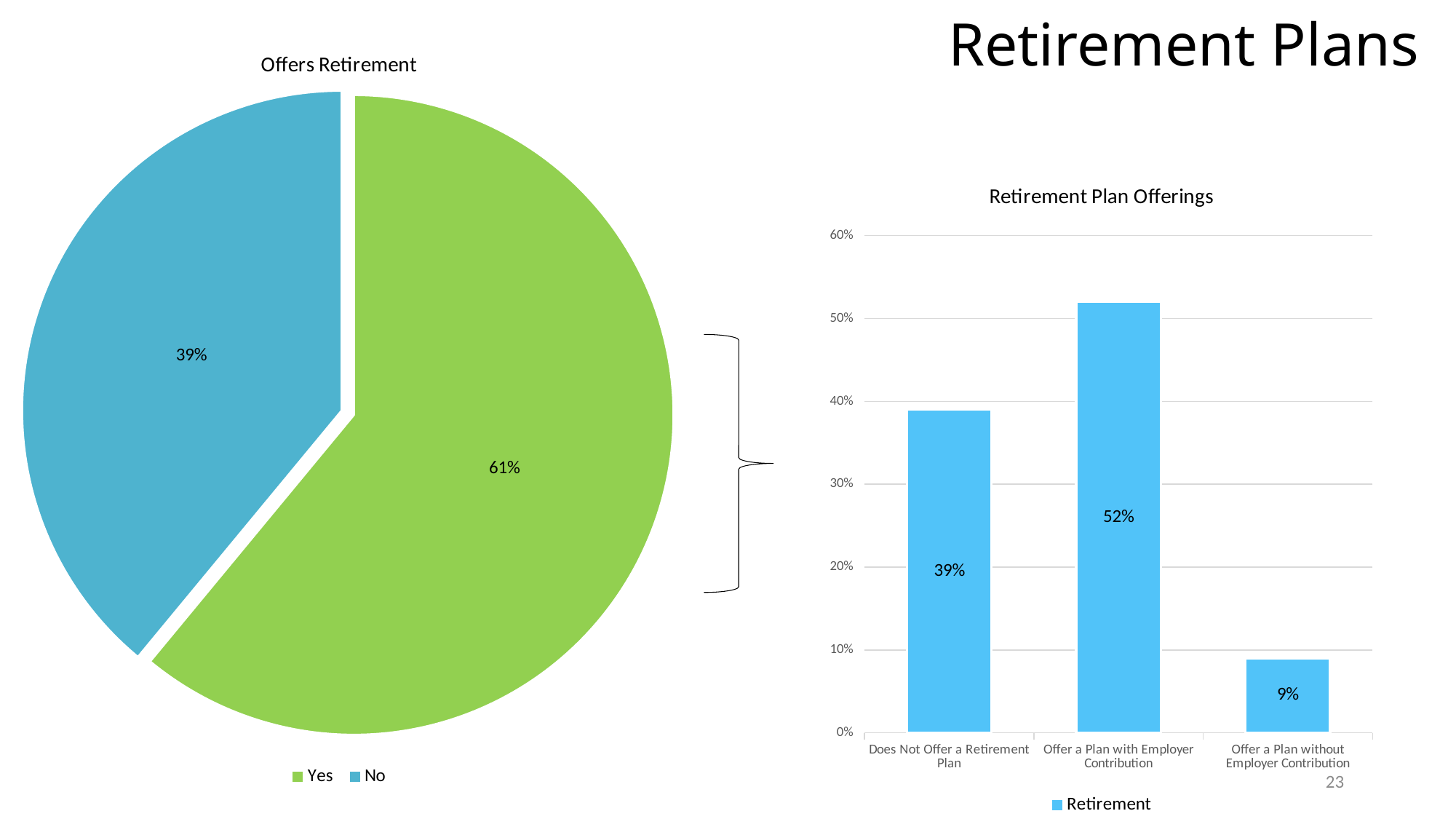
In the 'Retirement Plan Offerings' chart, which category has the lowest value? Offer a Plan without Employer Contribution What kind of chart is the 'Offers Retirement' chart? Pie chart What kind of chart is the 'Retirement Plan Offerings' chart? Bar chart How many categories are shown in the 'Retirement Plan Offerings' chart? 3 In the 'Retirement Plan Offerings' chart, what is the value for 'Offer a Plan without Employer Contribution'? 9% In the 'Offers Retirement' pie chart, what colour is the 'No' slice? Blue In the 'Retirement Plan Offerings' chart, which category has the highest value? Offer a Plan with Employer Contribution In the 'Offers Retirement' pie chart, what share is labelled for 'No'? 39% In the 'Offers Retirement' pie chart, which slice is larger, 'Yes' or 'No'? Yes In the 'Retirement Plan Offerings' chart, what is the difference between 'Offer a Plan with Employer Contribution' and 'Does Not Offer a Retirement Plan'? 13% In the 'Retirement Plan Offerings' chart, what is the value for 'Offer a Plan with Employer Contribution'? 52% In the 'Offers Retirement' pie chart, what share is labelled for 'Yes'? 61%